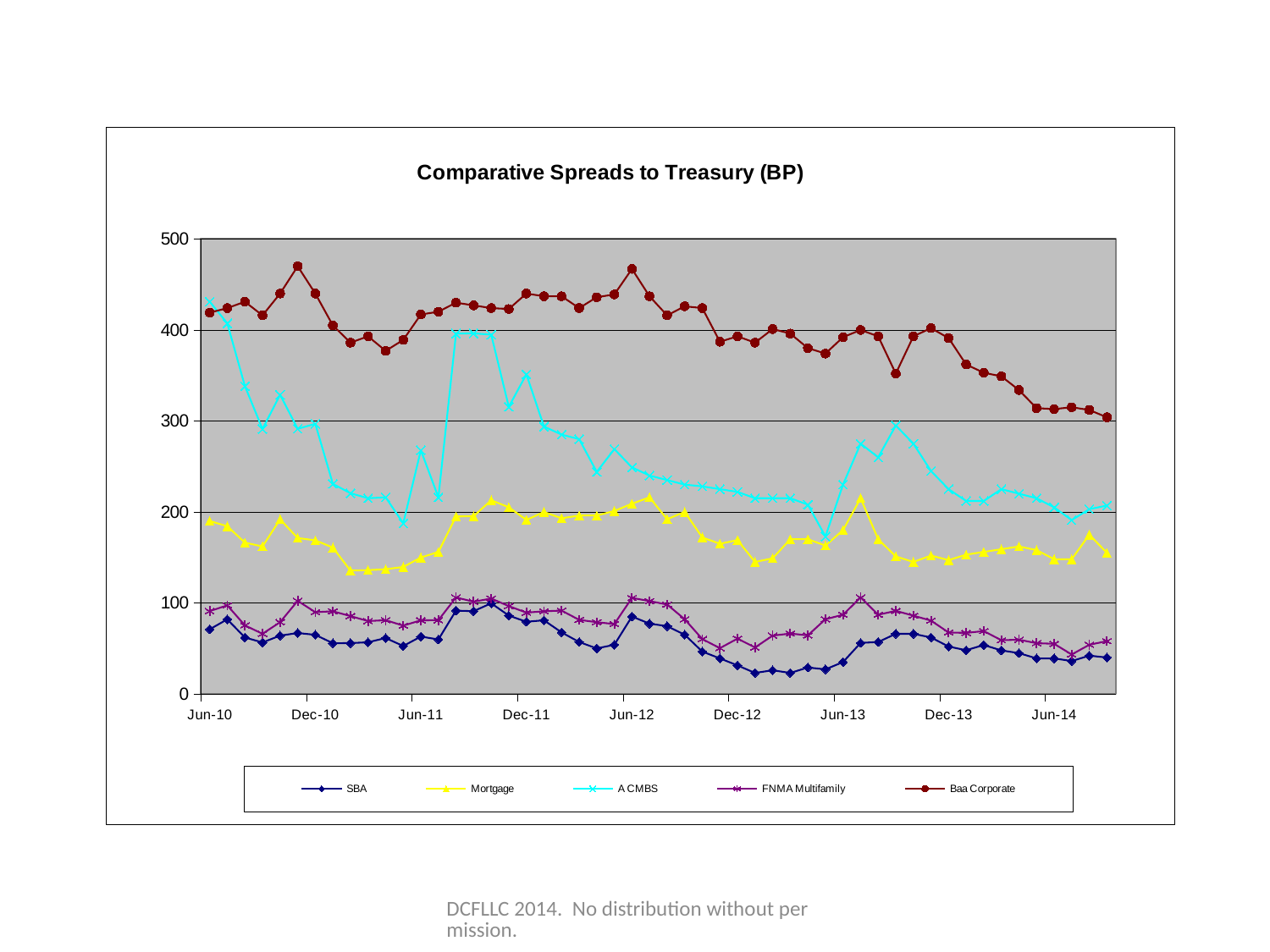
Which series has the lowest values across the whole chart? SBA Is the value for SBA at Jun-10 greater or less than 100? less Is the value for Baa Corporate at Jun-10 greater or less than 400? greater How many series does the legend list? 5 What is the title of the chart? Comparative Spreads to Treasury (BP) At Jun-12, which is larger: Baa Corporate or A CMBS? Baa Corporate Is the value for Baa Corporate at Jun-14 greater or less than 300? greater Does the Baa Corporate series rise or fall from Dec-13 to Jun-14? fall Which series has the highest value at Jun-14? Baa Corporate Which series is drawn in yellow? Mortgage What kind of chart is shown on the slide? line chart